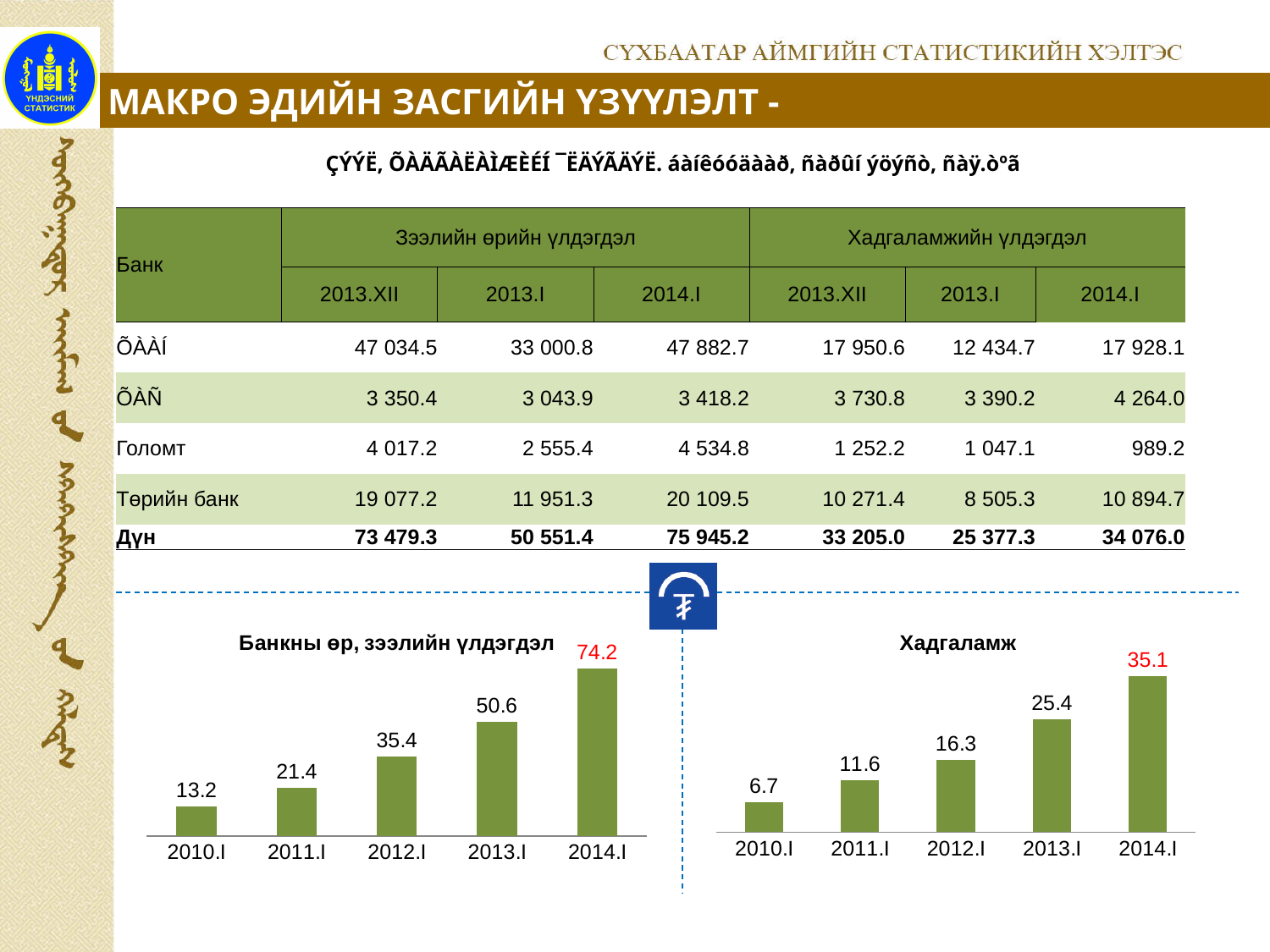
What type of chart is the chart titled "Банкны өр, зээлийн үлдэгдэл"? Bar chart In the chart titled "Хадгаламж", do the values rise or fall from 2010.I to 2014.I? Rise In the chart titled "Хадгаламж", what is the value for 2013.I? 25.4 In the chart titled "Хадгаламж", what is the difference between the values for 2012.I and 2010.I? 9.6 In the chart titled "Банкны өр, зээлийн үлдэгдэл", what is the difference between the values for 2014.I and 2013.I? 23.6 How many bars are shown in the chart titled "Хадгаламж"? 5 In the chart titled "Банкны өр, зээлийн үлдэгдэл", what is the value for 2012.I? 35.4 In the chart titled "Хадгаламж", what is the value for 2011.I? 11.6 In the chart titled "Хадгаламж", which year has the highest value? 2014.I In the chart titled "Банкны өр, зээлийн үлдэгдэл", which year has the lowest value? 2010.I In the chart titled "Банкны өр, зээлийн үлдэгдэл", what is the value for 2014.I? 74.2 Which is larger: the 2013.I value in the chart titled "Банкны өр, зээлийн үлдэгдэл" or the 2014.I value in the chart titled "Хадгаламж"? 2013.I in Банкны өр, зээлийн үлдэгдэл (50.6)